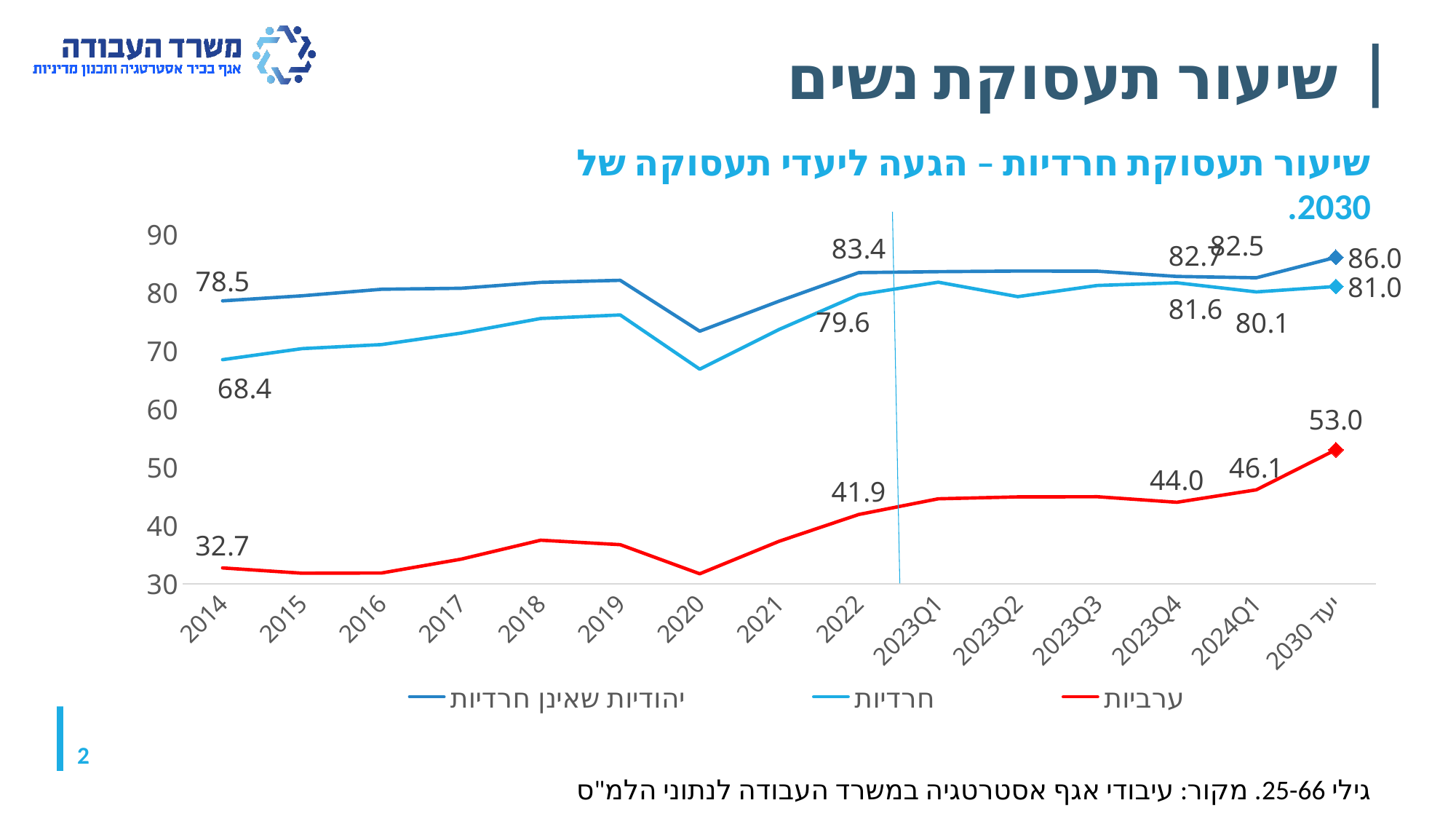
Which is larger in 2022: the value for יהודיות שאינן חרדיות or the value for חרדיות? יהודיות שאינן חרדיות What is the 2030 target value (יעד 2030) for ערביות? 53.0 What is the value for חרדיות in 2014? 68.4 What kind of chart is shown on the slide? line chart Is the value for ערביות in 2020 greater or less than 40? less What is the value for ערביות in 2014? 32.7 What is the 2030 target value (יעד 2030) for יהודיות שאינן חרדיות? 86.0 Which series has the lowest value in 2014? ערביות What is the value for ערביות in 2022? 41.9 What is the difference between the 2030 target for ערביות (53.0) and their 2014 value (32.7)? 20.3 How many points are on the x axis? 15 How many series does the legend list? 3